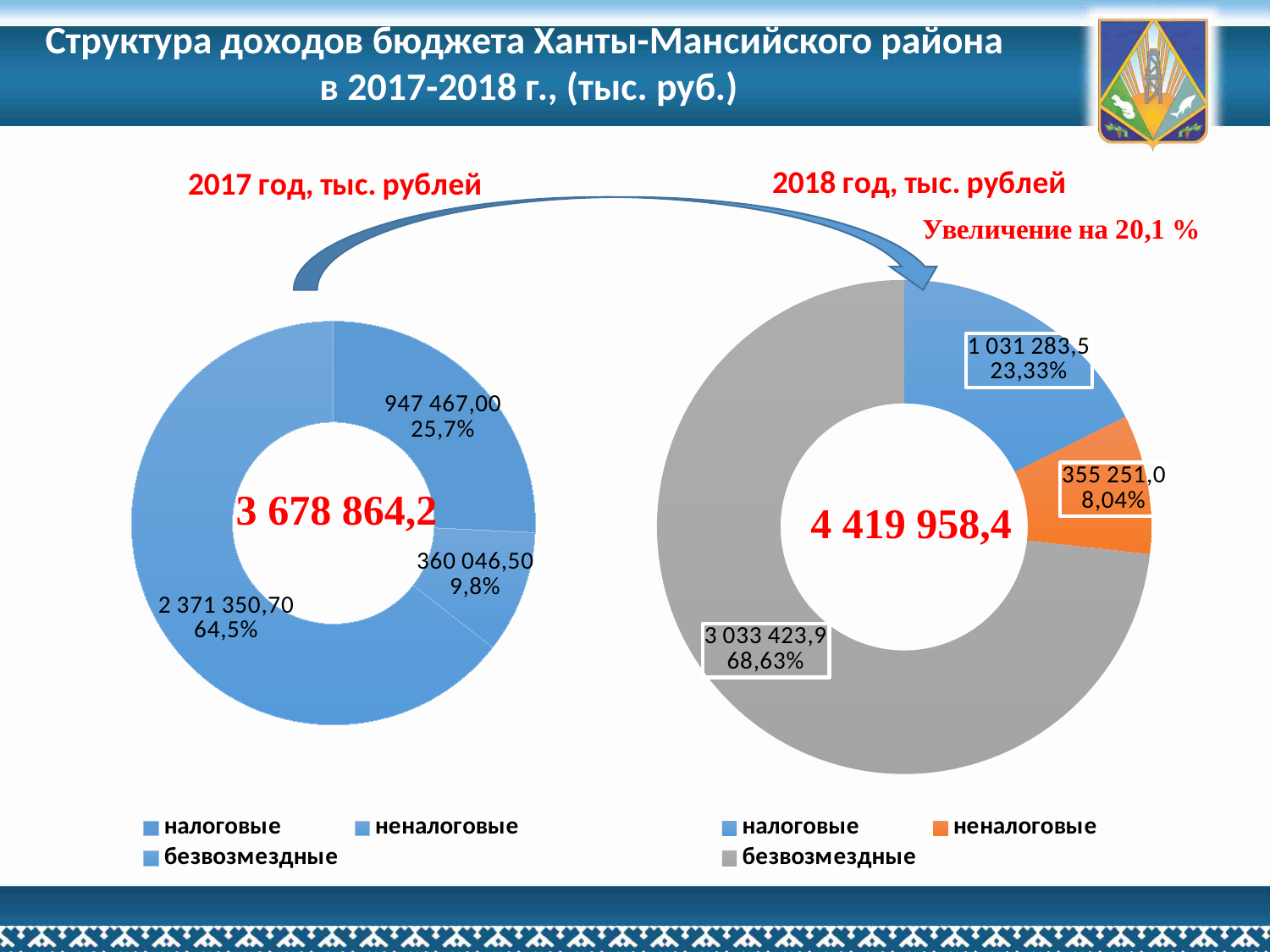
In the 2017 chart (left), what is the value of the slice labelled 9,8%? 360 046,50 In the 2018 chart (right), what share of the total do безвозмездные revenues make up? 68,63% What total is shown in the centre of the 2018 chart (right)? 4 419 958,4 In the 2018 chart (right), what is the difference between the налоговые and неналоговые values? 676 032,5 What total is shown in the centre of the 2017 chart (left)? 3 678 864,2 In the 2018 chart (right), what is the value for неналоговые? 355 251,0 In the 2018 chart (right), which category is the largest? безвозмездные How many categories does the legend of the 2018 chart (right) list? 3 In the 2018 chart (right), what is the value for налоговые? 1 031 283,5 In the 2017 chart (left), what percentage share is shown for the largest slice? 64,5% In the 2018 chart (right), which category is the smallest? неналоговые What type of chart is used on this slide? doughnut (pie) chart